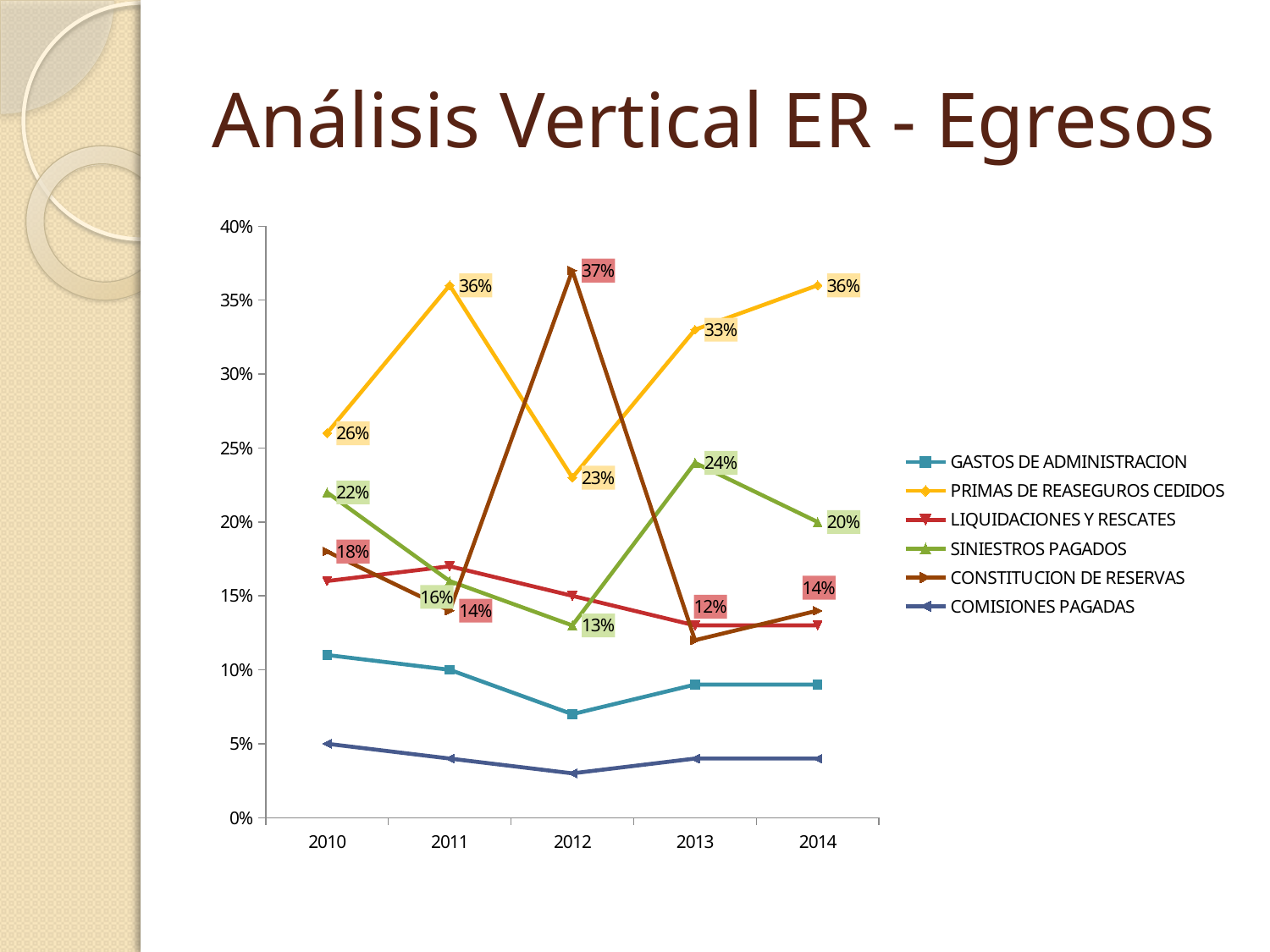
In which year is PRIMAS DE REASEGUROS CEDIDOS lowest? 2012 How many years are shown on the x axis? 5 Is the value for GASTOS DE ADMINISTRACION in 2012 greater or less than 10%? less How many series does the legend list? 6 By how many percentage points did PRIMAS DE REASEGUROS CEDIDOS change from 2010 to 2011? 10 percentage points What is the value for PRIMAS DE REASEGUROS CEDIDOS in 2014? 36% In 2013, which is larger: SINIESTROS PAGADOS or CONSTITUCION DE RESERVAS? SINIESTROS PAGADOS What kind of chart is shown on the slide? Line chart What is the value for CONSTITUCION DE RESERVAS in 2012? 37% In which year is SINIESTROS PAGADOS highest? 2013 Does the value for COMISIONES PAGADAS rise or fall from 2010 to 2012? Fall What is the value for SINIESTROS PAGADOS in 2010? 22%